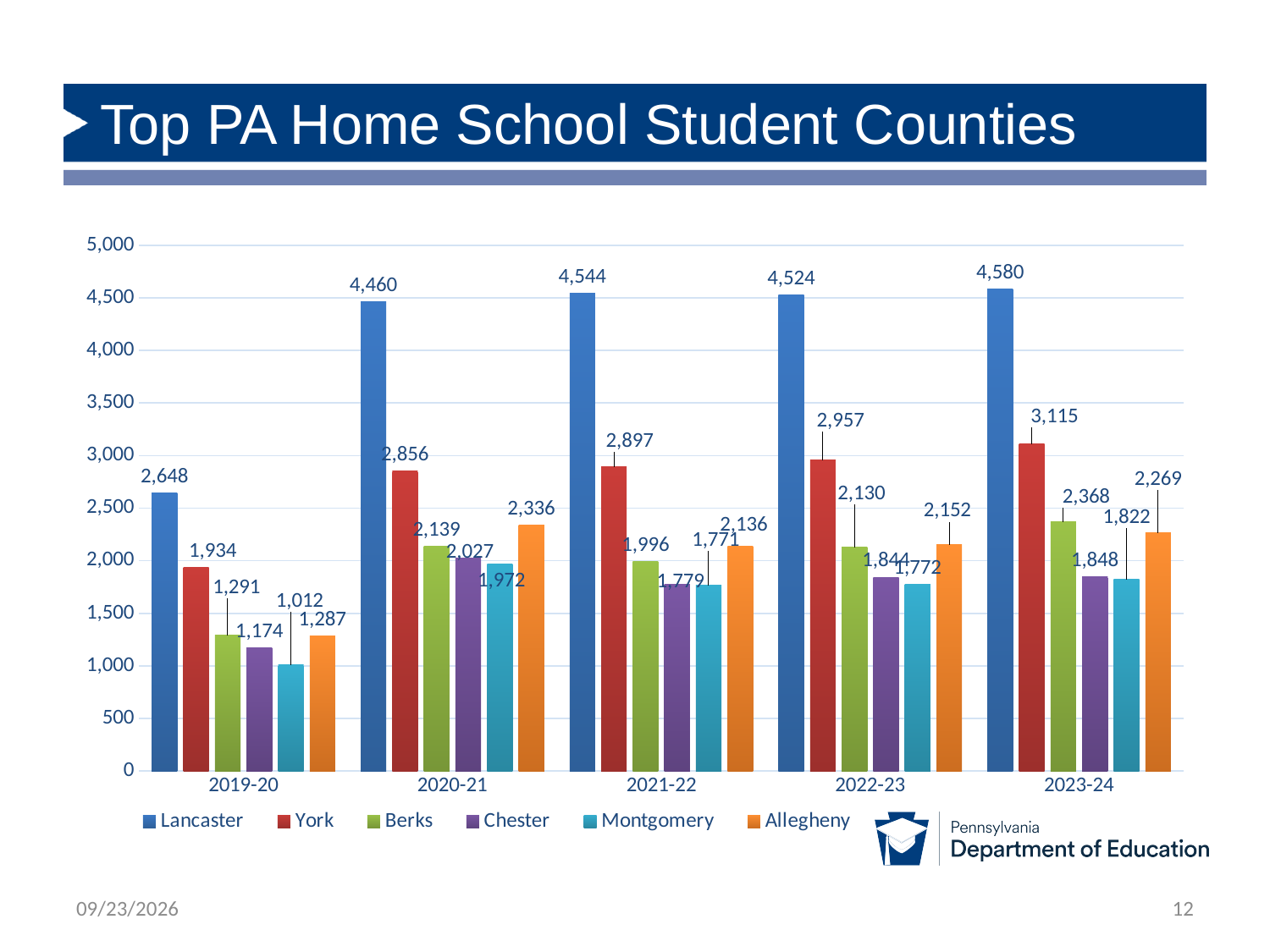
Which is larger in 2023-24, Berks or Allegheny? Berks What is the title of the chart? Top PA Home School Student Counties Does Lancaster's value rise or fall from 2019-20 to 2020-21? rise Which county has the highest value in 2021-22? Lancaster What kind of chart is shown on the slide? bar chart What is the value for Allegheny in 2019-20? 1,287 What is the difference between Lancaster's value in 2020-21 and in 2019-20? 1,812 Which county has the lowest value in 2019-20? Montgomery What is the value for York in 2020-21? 2,856 How many series does the legend list? 6 How many school years are shown on the x axis? 5 What is the value for Lancaster in 2023-24? 4,580